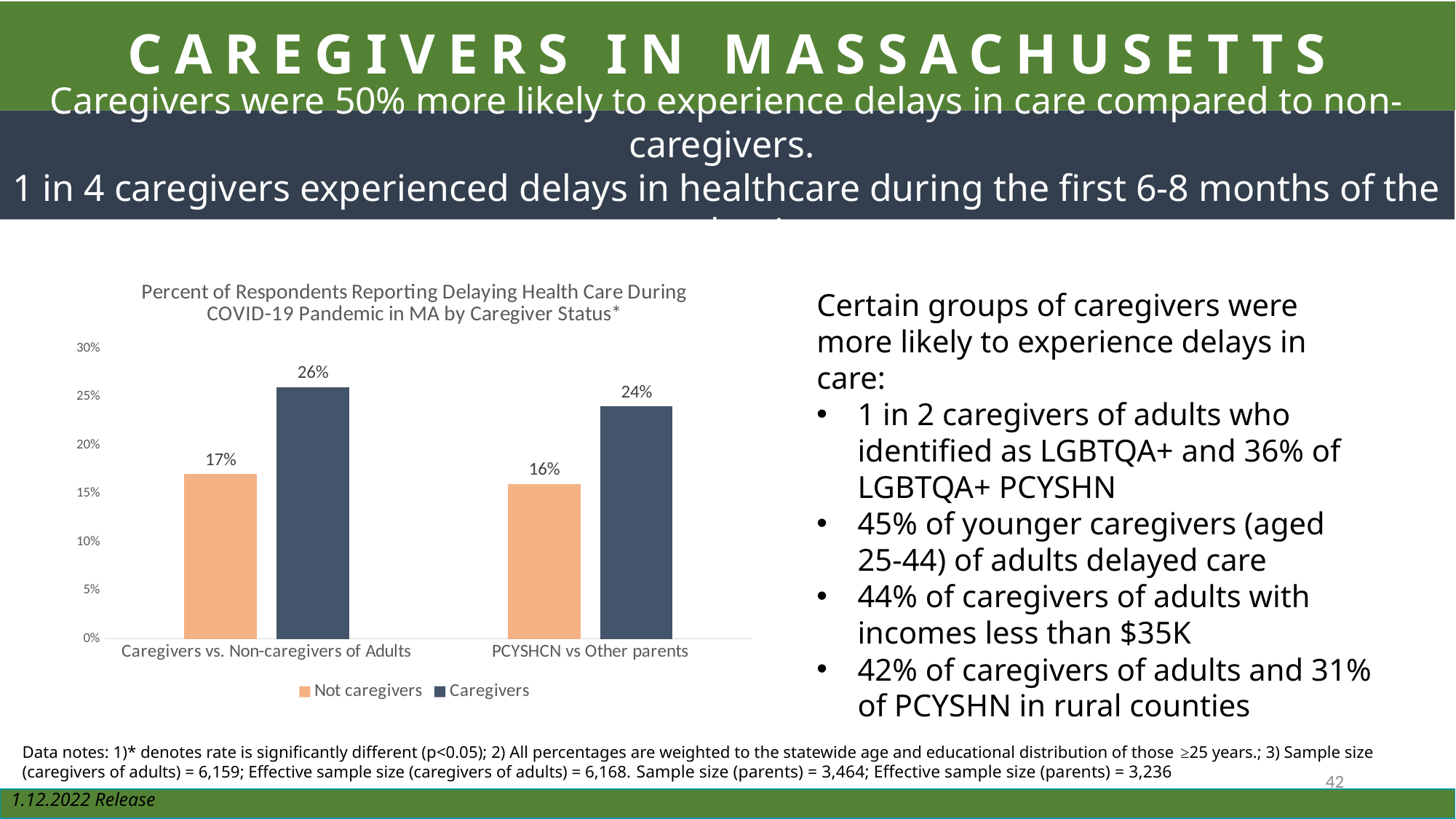
What is the value for Not caregivers in the 'Caregivers vs. Non-caregivers of Adults' category? 17% What is the difference between the Caregivers and Not caregivers values in the 'Caregivers vs. Non-caregivers of Adults' category? 9% What is the difference between the Caregivers and Not caregivers values in the 'PCYSHCN vs Other parents' category? 8% What percentage of not caregivers in the 'PCYSHCN vs Other parents' group reported delaying health care? 16% In the 'PCYSHCN vs Other parents' category, which series has the larger value, Caregivers or Not caregivers? Caregivers What type of chart is shown on the slide? Bar chart What percentage of caregivers in the 'Caregivers vs. Non-caregivers of Adults' group reported delaying health care? 26% What is the value for Caregivers in the 'PCYSHCN vs Other parents' category? 24% Which bar in the chart has the highest value? Caregivers, Caregivers vs. Non-caregivers of Adults (26%) How many series does the chart legend list? 2 Which bar in the chart has the lowest value? Not caregivers, PCYSHCN vs Other parents (16%) What colour are the Caregivers bars in the chart? Dark blue